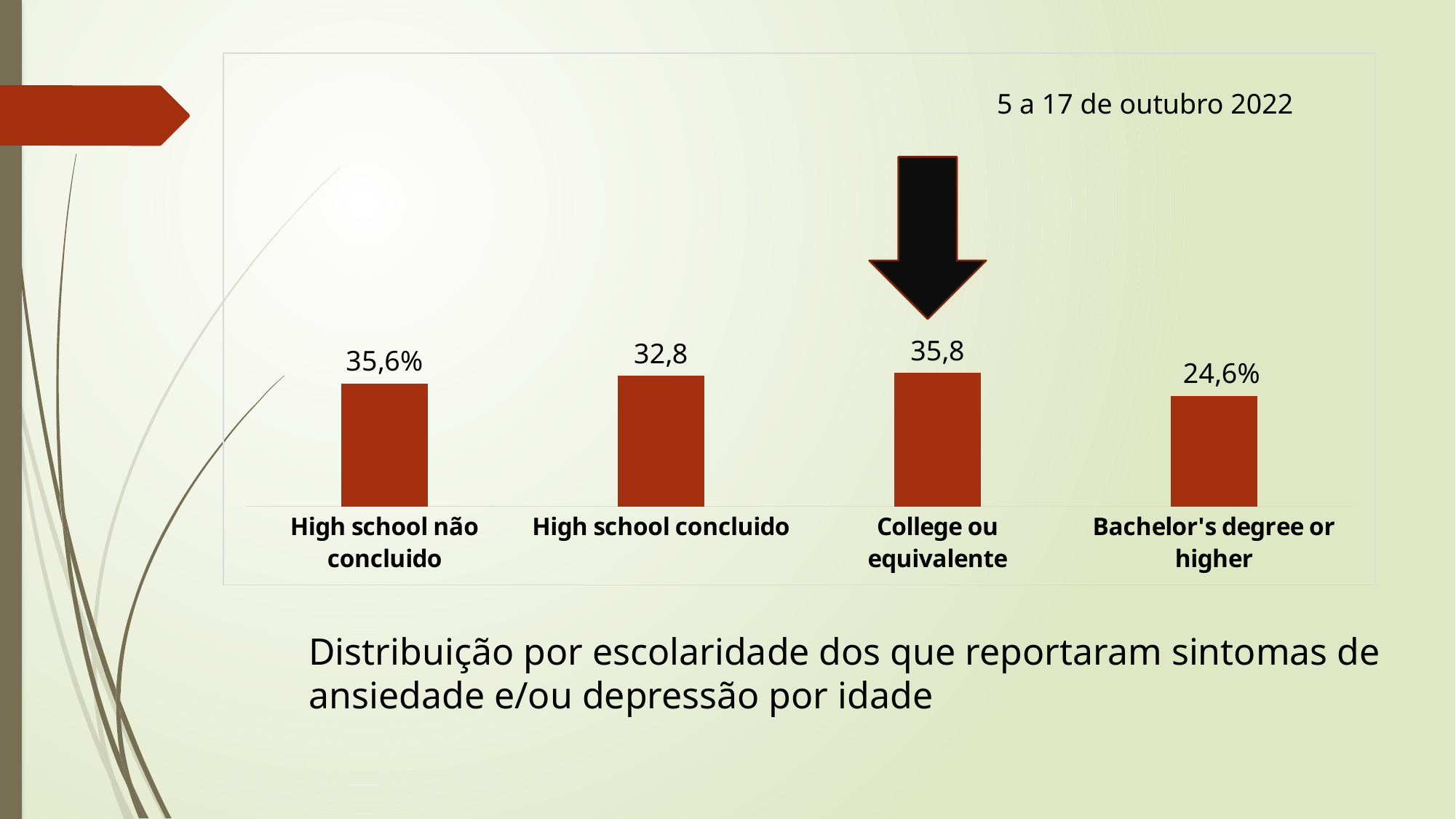
How many categories are shown in the chart? 4 Which category has the highest value? College ou equivalente What date range is shown above the chart? 5 a 17 de outubro 2022 What is the value for College ou equivalente? 35,8 What is the value for High school não concluido? 35,6% What kind of chart is shown on the slide? Bar chart What is the value for Bachelor's degree or higher? 24,6% What is the value for High school concluido? 32,8 Which is larger, the value for High school concluido or the value for Bachelor's degree or higher? High school concluido Which category has the lowest value? Bachelor's degree or higher What is the difference between the values for College ou equivalente and High school concluido? 3 What is the difference between the values for High school não concluido and Bachelor's degree or higher? 11